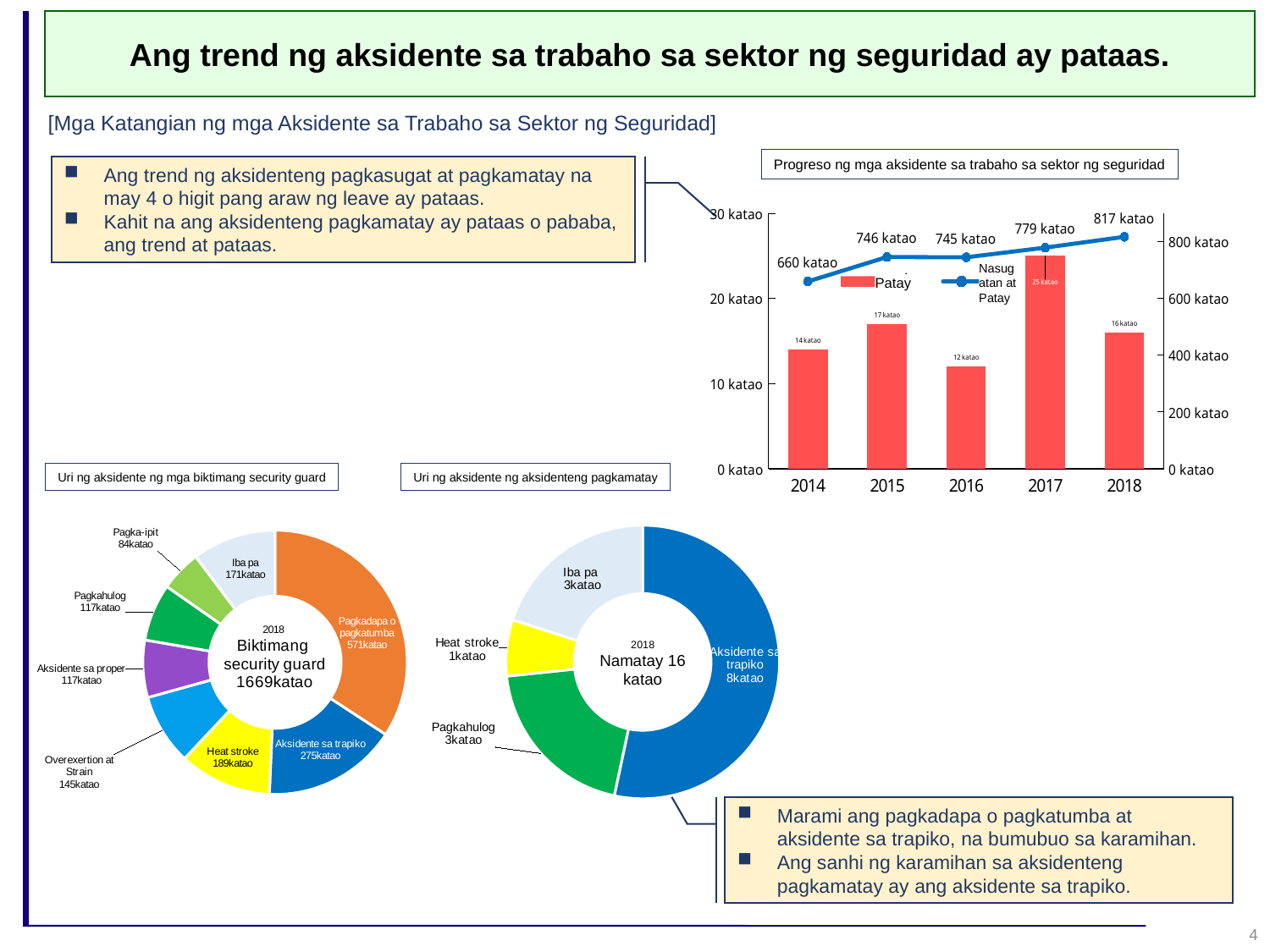
In the chart 'Uri ng aksidente ng mga biktimang security guard', which is larger: Heat stroke or Overexertion at Strain? Heat stroke In the chart 'Uri ng aksidente ng mga biktimang security guard', what is the value for Pagkadapa o pagkatumba? 571katao In the chart 'Progreso ng mga aksidente sa trabaho sa sektor ng seguridad', what is the Nasugatan at Patay value for 2018? 817 katao In the chart 'Progreso ng mga aksidente sa trabaho sa sektor ng seguridad', what is the value of the Patay bar for 2017? 25 katao In the chart 'Progreso ng mga aksidente sa trabaho sa sektor ng seguridad', which year has the lowest Patay bar? 2016 In the chart 'Uri ng aksidente ng mga biktimang security guard', which category has the largest slice? Pagkadapa o pagkatumba What kind of chart is 'Uri ng aksidente ng aksidenteng pagkamatay'? Donut (pie) chart In the chart 'Progreso ng mga aksidente sa trabaho sa sektor ng seguridad', which year has the highest Nasugatan at Patay value? 2018 In the chart 'Uri ng aksidente ng aksidenteng pagkamatay', what is the value for Aksidente sa trapiko? 8katao In the chart 'Progreso ng mga aksidente sa trabaho sa sektor ng seguridad', what is the difference between the Nasugatan at Patay values for 2018 and 2014? 157 katao In the chart 'Progreso ng mga aksidente sa trabaho sa sektor ng seguridad', how many series does the legend list? 2 In the chart 'Progreso ng mga aksidente sa trabaho sa sektor ng seguridad', does the Nasugatan at Patay line generally rise or fall from 2014 to 2018? rise